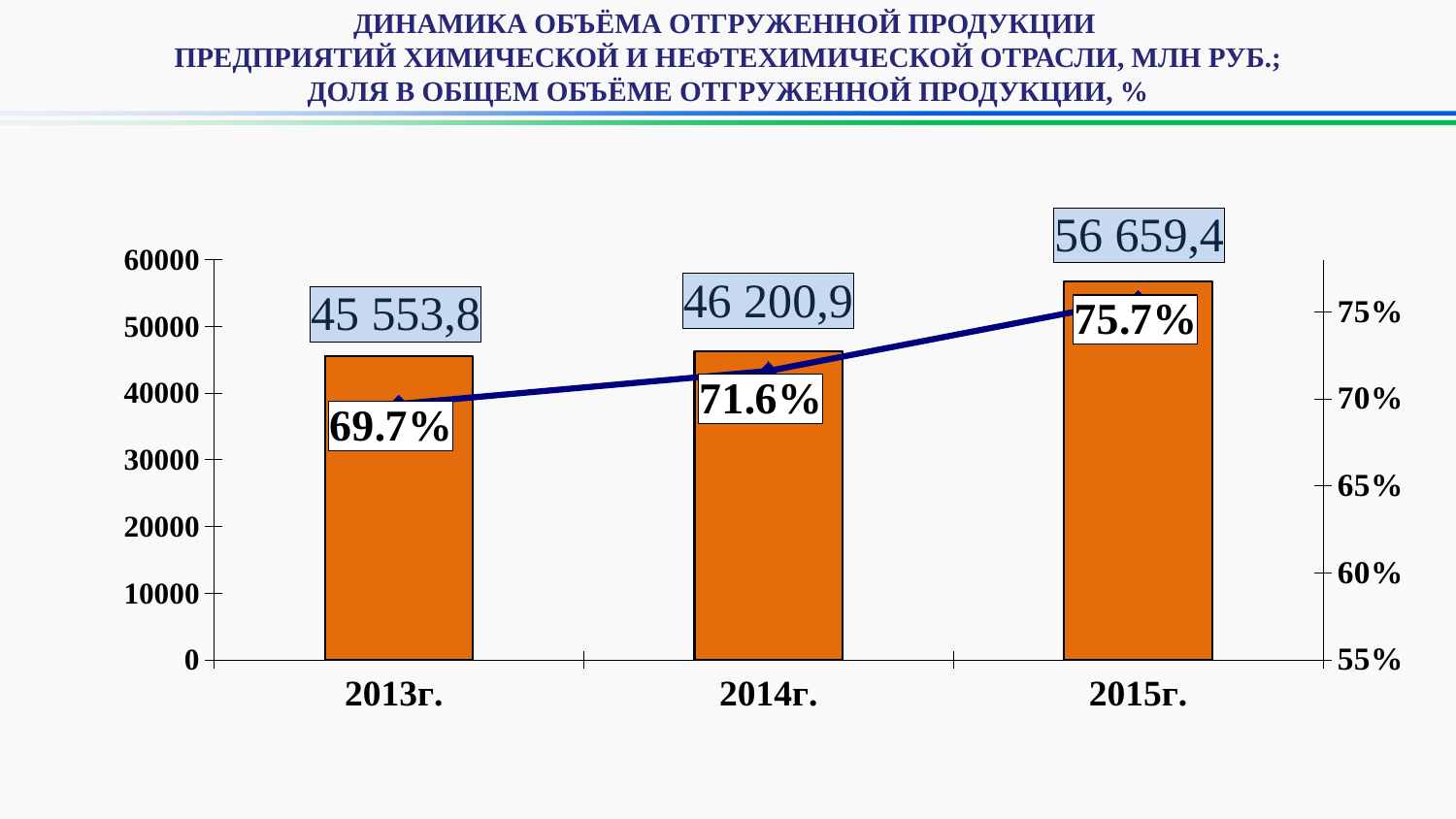
Which year has the highest volume of shipped products? 2015г. By how much (млн руб.) does the volume for 2015г. exceed the volume for 2013г.? 11 105,6 Does the share of total shipped products rise or fall from 2013г. to 2015г.? rise What is the volume of shipped products (млн руб.) shown for 2014г.? 46 200,9 How many years are shown on the x axis? 3 What is the difference in percentage points between the share for 2015г. and the share for 2013г.? 6.0 What is the volume of shipped products (млн руб.) shown for 2013г.? 45 553,8 What share (%) of total shipped products is shown for 2015г.? 75.7% What share (%) of total shipped products is shown for 2013г.? 69.7% Which year has the lowest share of total shipped products? 2013г. What is the volume of shipped products (млн руб.) shown for 2015г.? 56 659,4 Which is larger, the volume for 2014г. or the volume for 2013г.? 2014г.